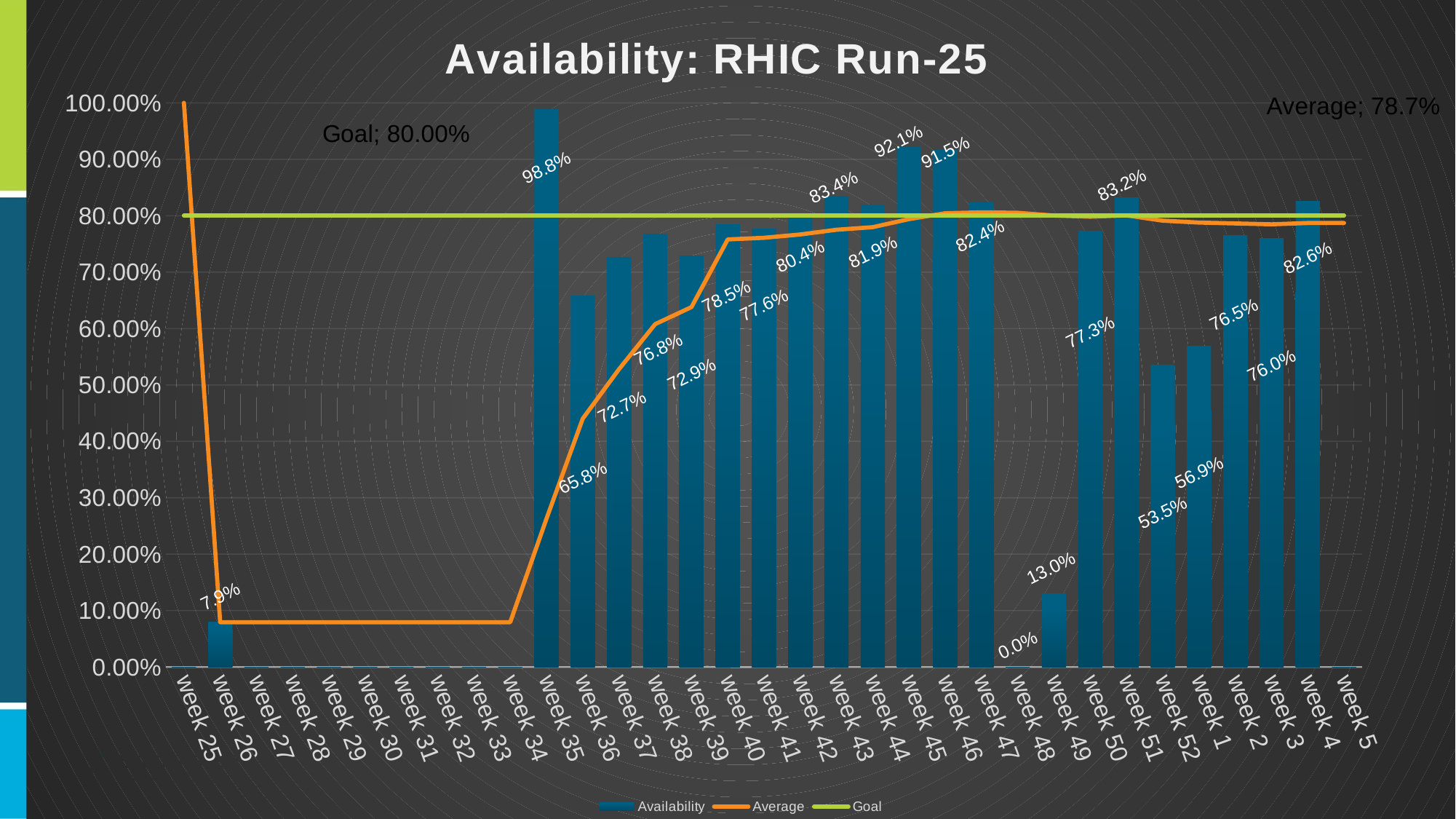
What is the title of the chart? Availability: RHIC Run-25 What is the Goal value shown on the chart? 80.00% Which is larger, the availability for week 52 or week 1? week 1 What is the availability value for week 35? 98.8% What is the availability value for week 49? 13.0% What is the difference between the availability for week 45 and week 46? 0.6% What kind of chart is used to show the Availability series? bar chart What is the Average value shown on the chart? 78.7% What is the availability value for week 45? 92.1% Is the availability for week 36 greater or less than 70.00%? less Which week has the highest availability? week 35 How many series does the legend list? 3